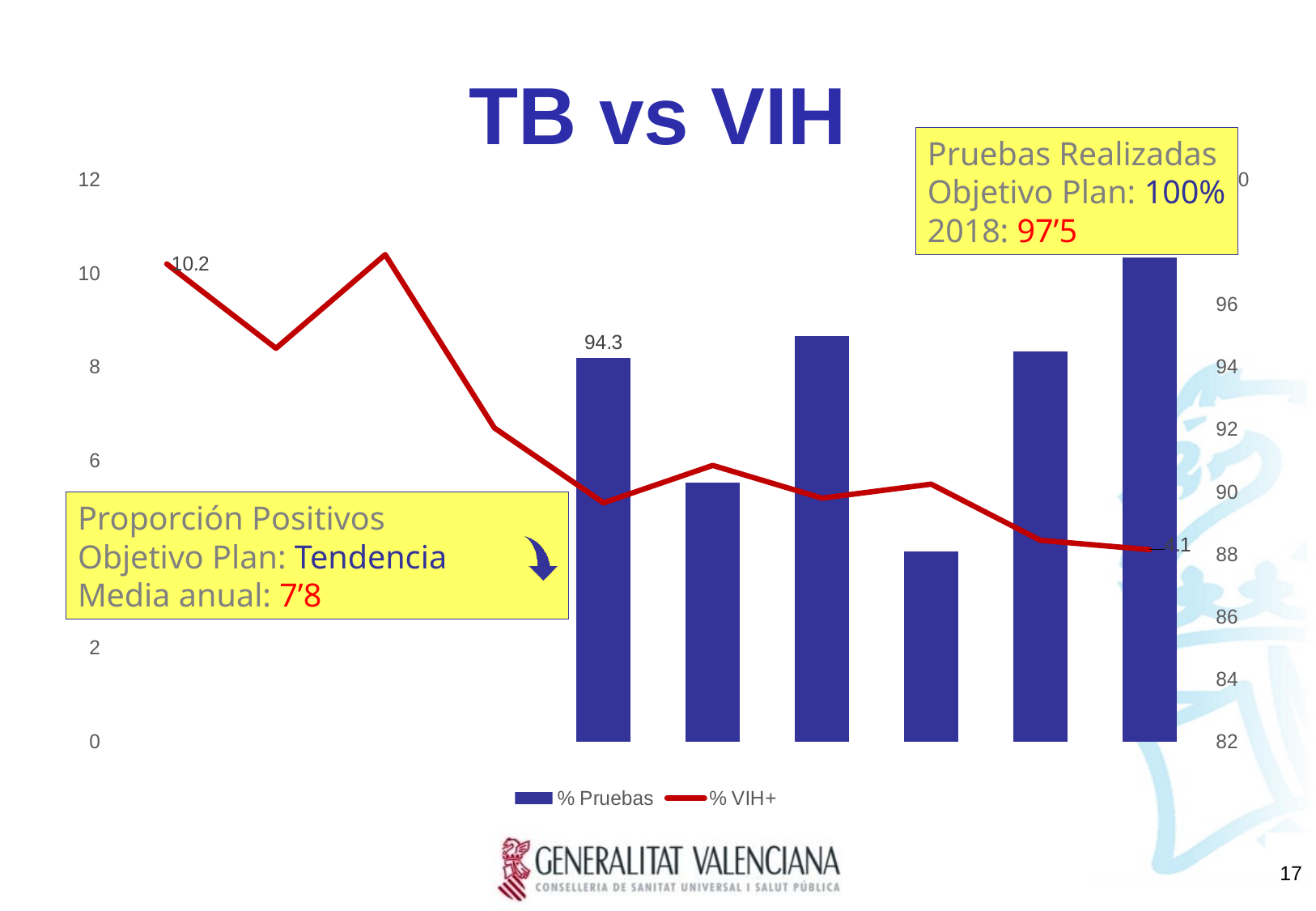
How many bars are plotted for the % Pruebas series? 6 What kind of chart is shown on the slide? A combined bar and line chart What are the two series named in the legend? % Pruebas and % VIH+ Which bar of the % Pruebas series is the shortest? The fourth bar What value is labelled on the first (leftmost) bar of the % Pruebas series? 94.3 What is the title of the chart? TB vs VIH How many series does the legend list? 2 Does the % VIH+ line generally rise or fall from left to right? Fall What value is labelled on the first (leftmost) point of the % VIH+ line? 10.2 Which is larger, the first % Pruebas bar or the second % Pruebas bar? The first bar Which bar of the % Pruebas series is the tallest? The sixth (rightmost) bar Is the value of the fourth % Pruebas bar greater or less than 90 on the right axis? less